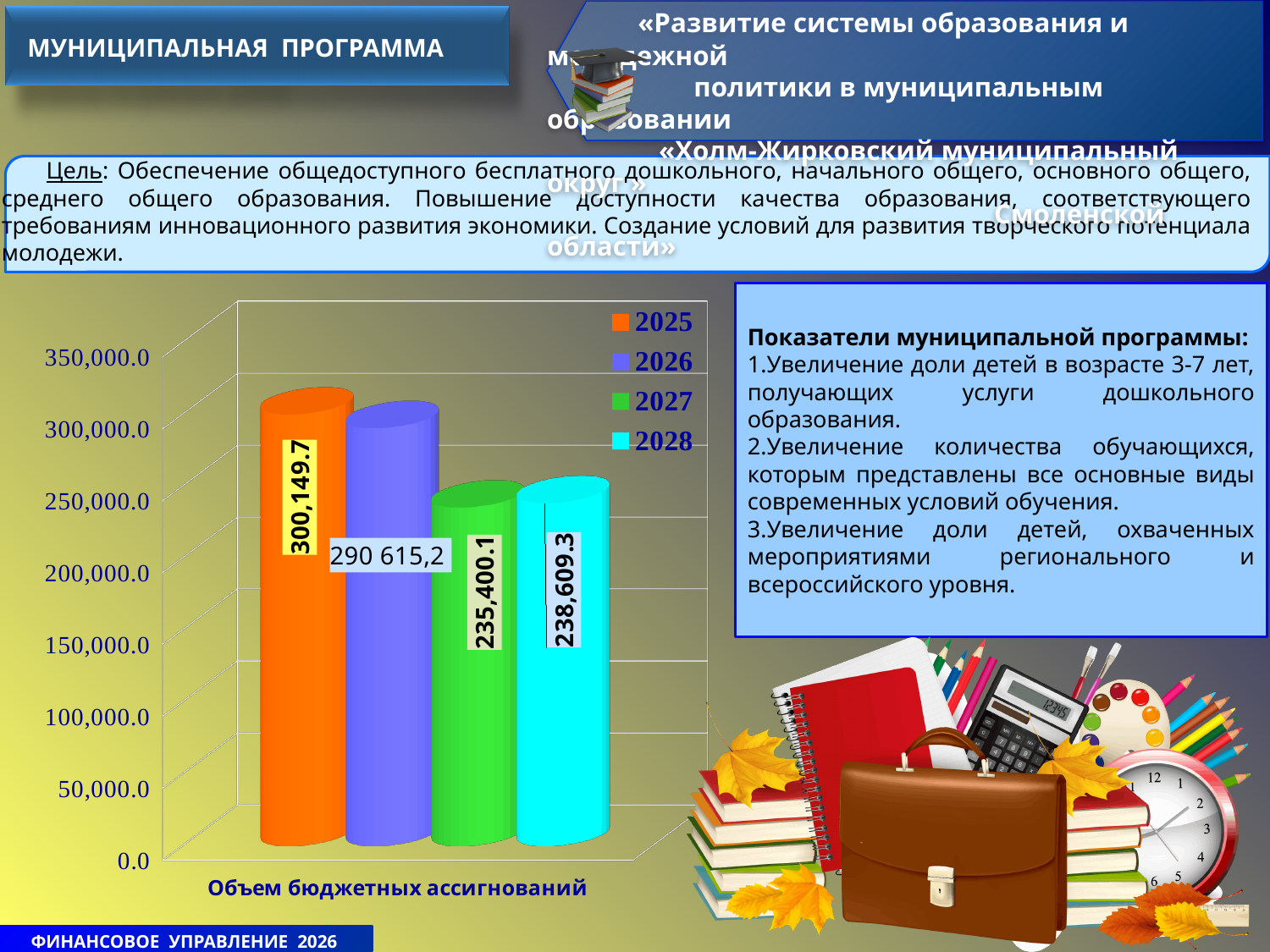
What kind of chart is shown on the slide? bar chart What is the value for 2027 in the chart? 235,400.1 What is the value for 2028 in the chart? 238,609.3 What is the value for 2025 in the chart? 300,149.7 Which is larger, the value for 2027 or the value for 2028? 2028 Which year has the highest value in the chart? 2025 What is the value for 2026 in the chart? 290 615,2 What is the category label shown under the bars? Объем бюджетных ассигнований Is the value for 2025 greater or less than 250,000.0? greater How many series does the legend list? 4 What is the difference between the values for 2025 and 2026? 9,534.5 Which year has the lowest value in the chart? 2027